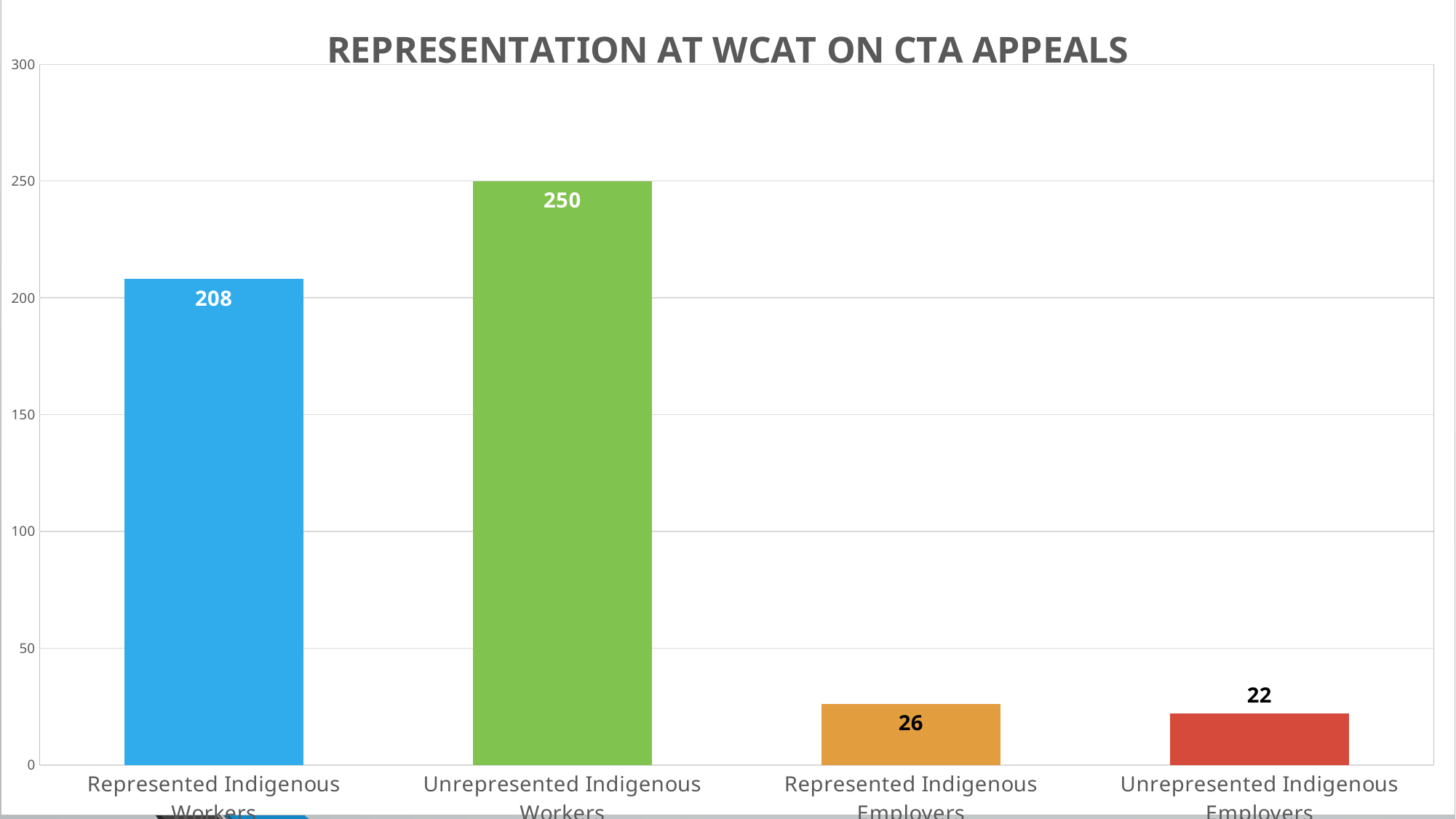
What is the value for Represented Indigenous Workers? 208 What is the value for Unrepresented Indigenous Workers? 250 Which is larger, Represented Indigenous Workers or Unrepresented Indigenous Workers? Unrepresented Indigenous Workers What is the value for Represented Indigenous Employers? 26 What is the difference between Represented Indigenous Employers and Unrepresented Indigenous Employers? 4 Which category has the highest value? Unrepresented Indigenous Workers How many categories are shown in the chart? 4 What is the difference between Unrepresented Indigenous Workers and Represented Indigenous Workers? 42 What is the title of the chart? REPRESENTATION AT WCAT ON CTA APPEALS Which category has the lowest value? Unrepresented Indigenous Employers What kind of chart is this? Bar chart What is the value for Unrepresented Indigenous Employers? 22